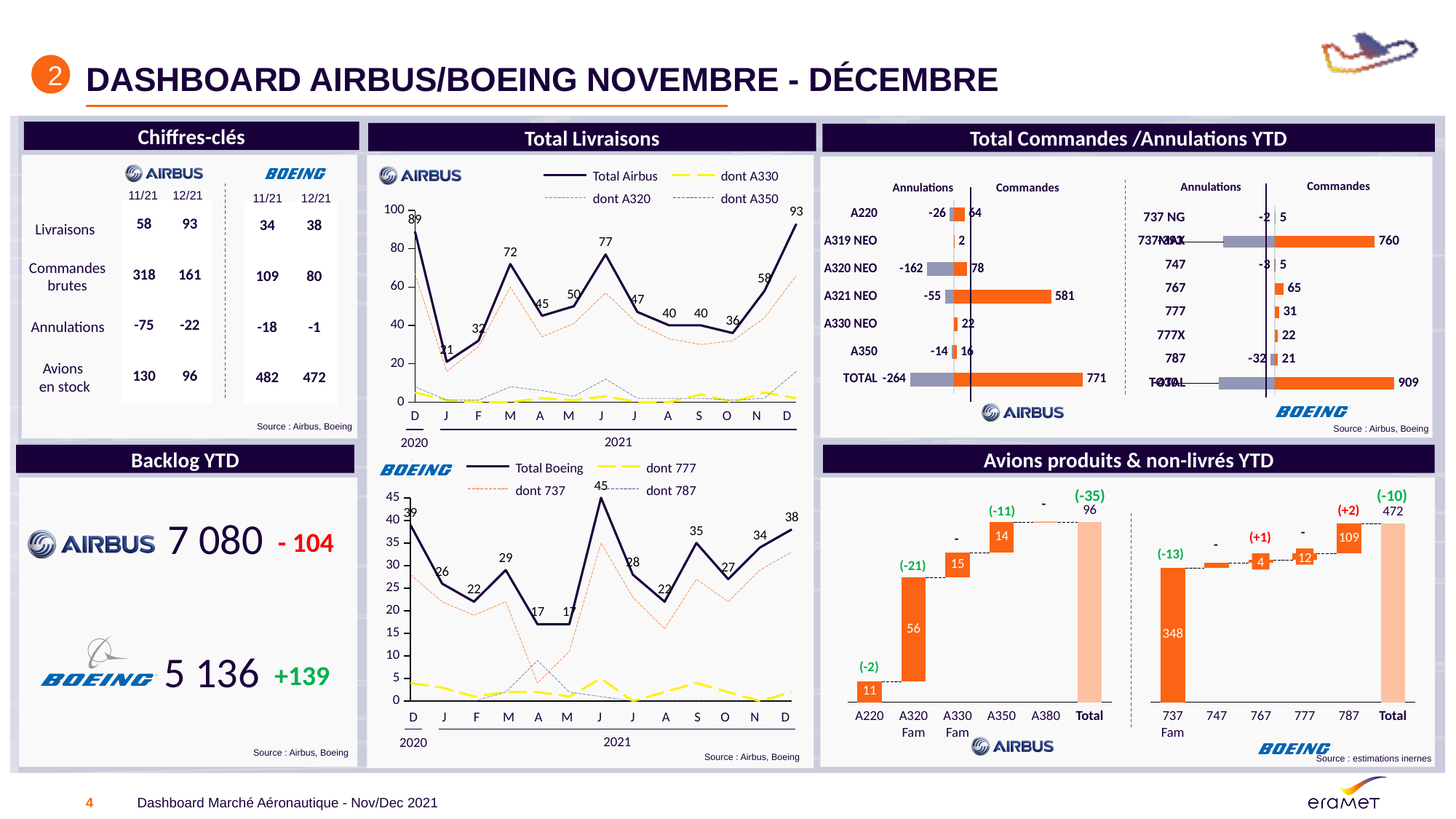
In the Avions produits & non-livrés YTD Boeing chart, what is the Total value? 472 In the Total Commandes / Annulations YTD Airbus chart, which aircraft has the largest Annulations value? A320 NEO (-162) In the Total Livraisons Airbus chart, what is the Total Airbus value for D 2021? 93 What kind of chart is the Total Livraisons Airbus chart? Line chart In the Total Livraisons Boeing chart, is the Total Boeing value for F (February 2021) larger than the value for S (September 2021)? No, S is larger (35 vs 22) How many series does the legend of the Total Livraisons Boeing chart list? 4 In the Total Livraisons Boeing chart, what is the highest Total Boeing value? 45 In the Total Livraisons Airbus chart, what is the difference between the Total Airbus values for M (March 2021) and A (April 2021)? 27 In the Total Commandes / Annulations YTD Airbus chart, what is the Commandes value for A321 NEO? 581 In the Total Commandes / Annulations YTD Boeing chart, what is the Commandes value for 737 MAX? 760 In the Avions produits & non-livrés YTD Airbus chart, what is the value for A320 Fam? 56 In the Total Livraisons Airbus chart, which month has the lowest Total Airbus value? J (January 2021)